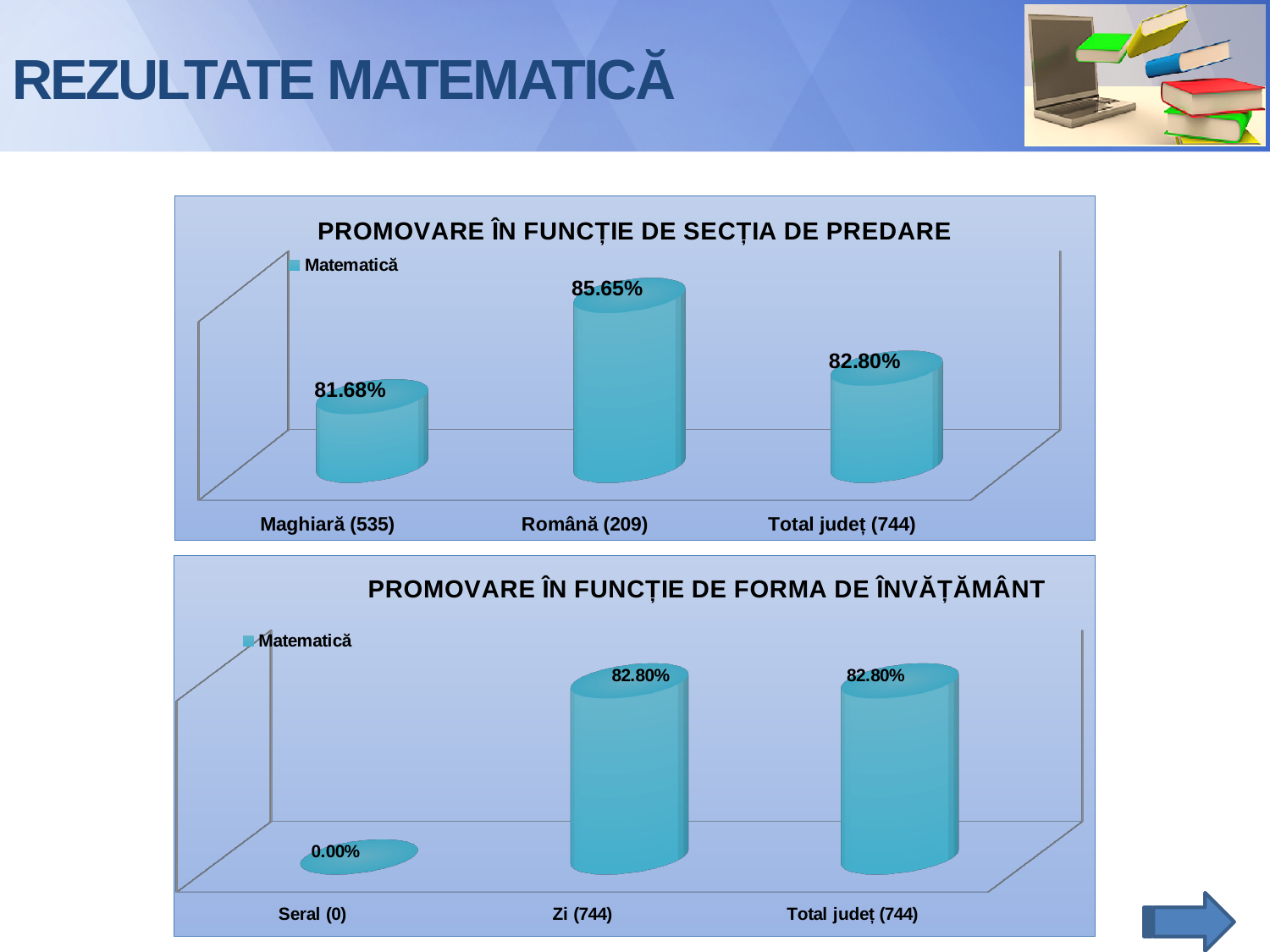
In the chart 'PROMOVARE ÎN FUNCȚIE DE FORMA DE ÎNVĂȚĂMÂNT', what is the value for Zi (744)? 82.80% How many series does the legend of the chart 'PROMOVARE ÎN FUNCȚIE DE FORMA DE ÎNVĂȚĂMÂNT' list? 1 In the chart 'PROMOVARE ÎN FUNCȚIE DE SECȚIA DE PREDARE', which category has the highest value? Română (209) In the chart 'PROMOVARE ÎN FUNCȚIE DE SECȚIA DE PREDARE', which category has the lowest value? Maghiară (535) In the chart 'PROMOVARE ÎN FUNCȚIE DE FORMA DE ÎNVĂȚĂMÂNT', what is the value for Seral (0)? 0.00% In the chart 'PROMOVARE ÎN FUNCȚIE DE SECȚIA DE PREDARE', what is the value for Maghiară (535)? 81.68% In the chart 'PROMOVARE ÎN FUNCȚIE DE SECȚIA DE PREDARE', what is the value for Română (209)? 85.65% What kind of chart is 'PROMOVARE ÎN FUNCȚIE DE SECȚIA DE PREDARE'? Bar chart In the chart 'PROMOVARE ÎN FUNCȚIE DE SECȚIA DE PREDARE', how many categories are shown? 3 In the chart 'PROMOVARE ÎN FUNCȚIE DE SECȚIA DE PREDARE', what is the difference between the values for Română (209) and Maghiară (535)? 3.97% In the chart 'PROMOVARE ÎN FUNCȚIE DE FORMA DE ÎNVĂȚĂMÂNT', which is larger: the value for Zi (744) or Seral (0)? Zi (744) In the chart 'PROMOVARE ÎN FUNCȚIE DE FORMA DE ÎNVĂȚĂMÂNT', which category has the lowest value? Seral (0)